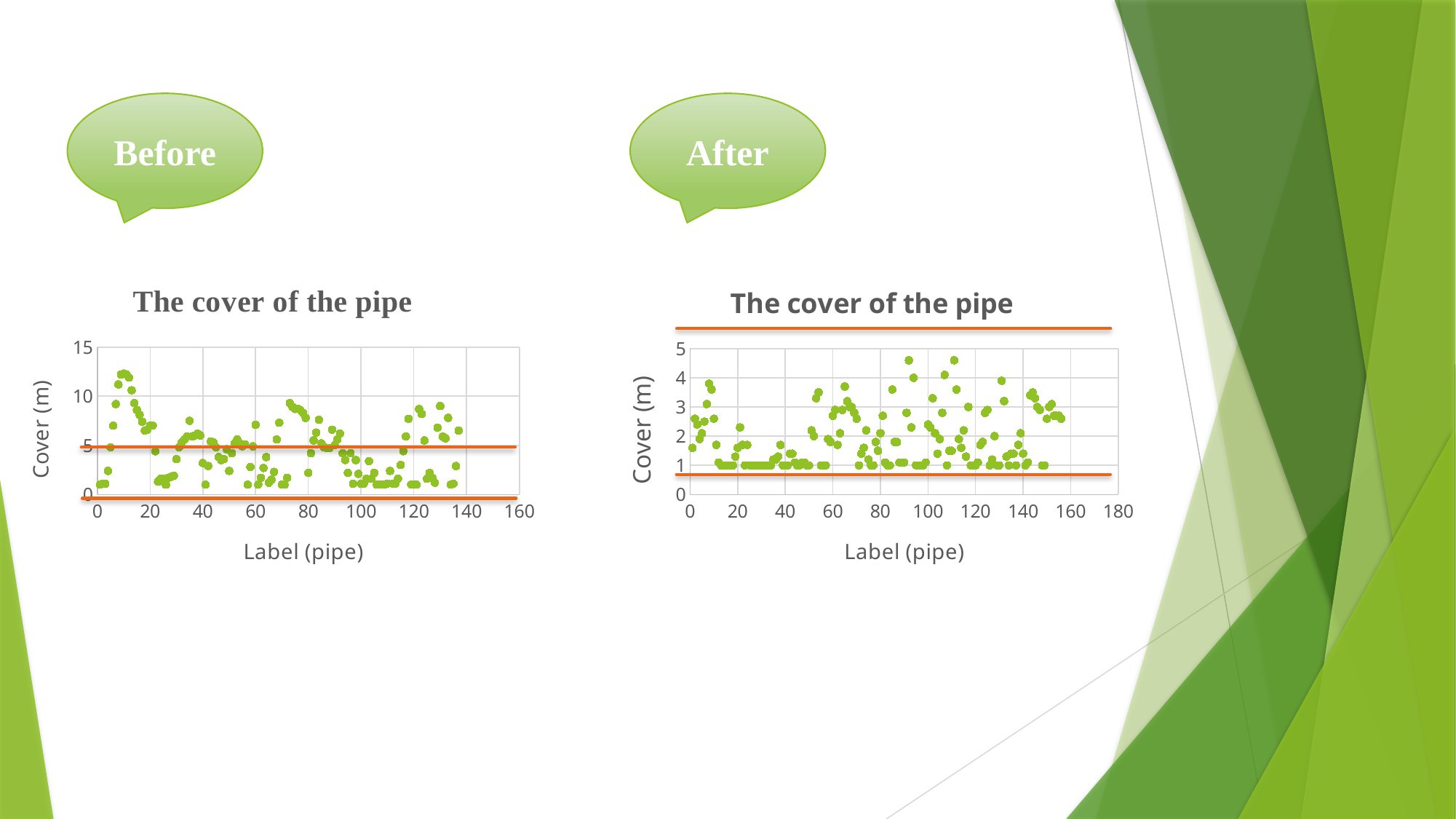
How many charts are shown on the slide? 2 In the 'After' chart on the right, is the highest plotted cover value greater or less than 4? greater What is the maximum value shown on the y-axis of the 'After' chart on the right? 5 In the 'Before' chart on the left, is the highest plotted cover value greater or less than 10? greater In the 'Before' chart on the left, is the highest plotted cover value greater or less than 15? less What is the y-axis title of the 'After' chart on the right? Cover (m) What is the maximum value shown on the y-axis of the 'Before' chart on the left? 15 What kind of chart is the 'Before' chart on the left? scatter chart What kind of chart is the 'After' chart on the right? scatter chart What is the maximum value shown on the x-axis of the 'After' chart on the right? 180 What is the title of the 'Before' chart on the left? The cover of the pipe